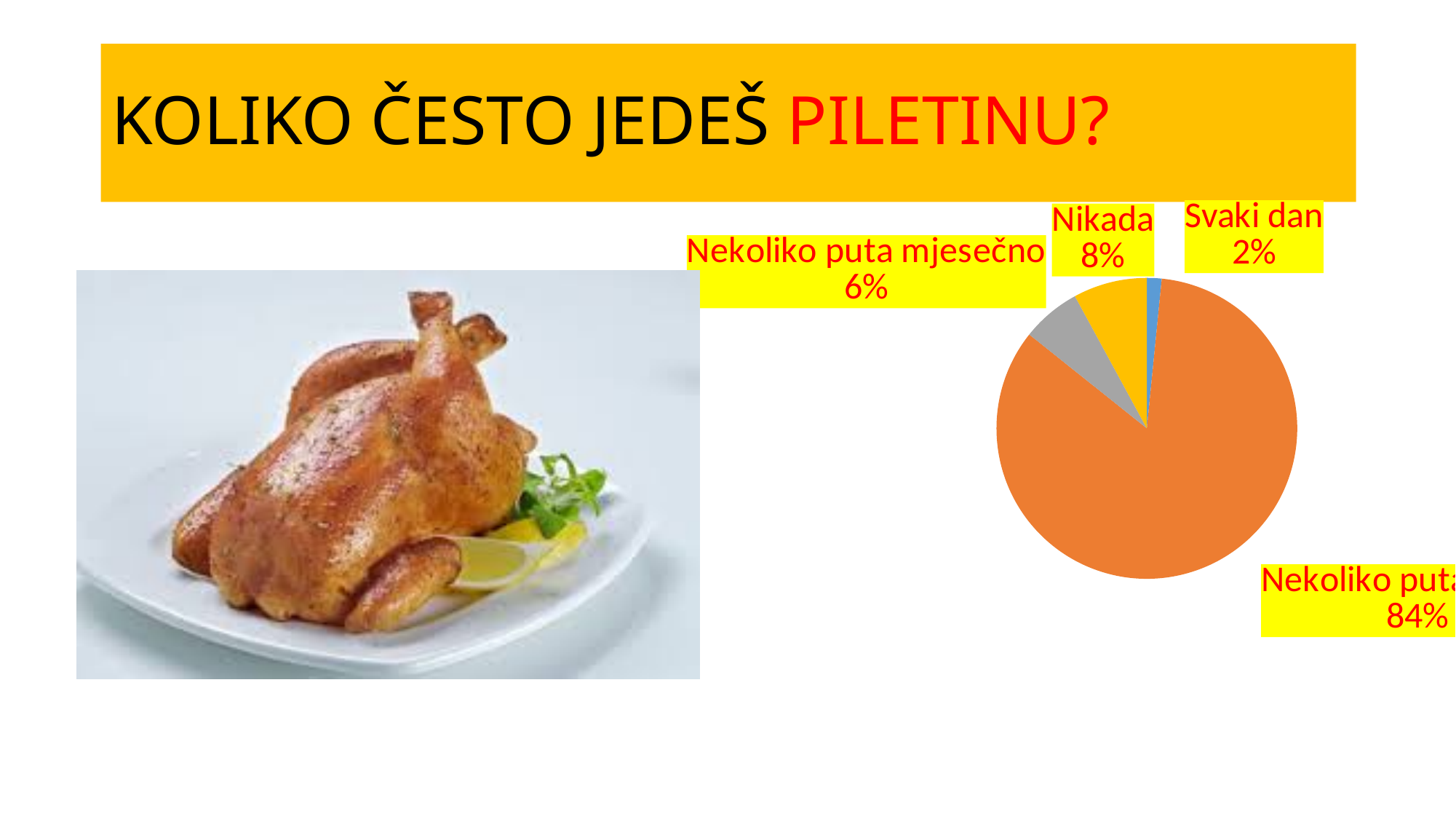
Which is larger, the slice for "Nikada" or the slice for "Svaki dan"? Nikada What is the title of the slide? KOLIKO ČESTO JEDEŠ PILETINU? Which category has the smallest slice of the pie? Svaki dan What is the difference between the percentages for "Nikada" and "Nekoliko puta mjesečno"? 2% What percentage is shown for "Nekoliko puta mjesečno"? 6% What percentage is shown for the largest slice of the pie? 84% What is the difference between the percentages for "Nikada" and "Svaki dan"? 6% What percentage is shown for "Svaki dan"? 2% What kind of chart is shown on the slide? pie chart How many slices does the pie chart have? 4 What colour is the largest slice of the pie chart? orange What percentage is shown for "Nikada"? 8%